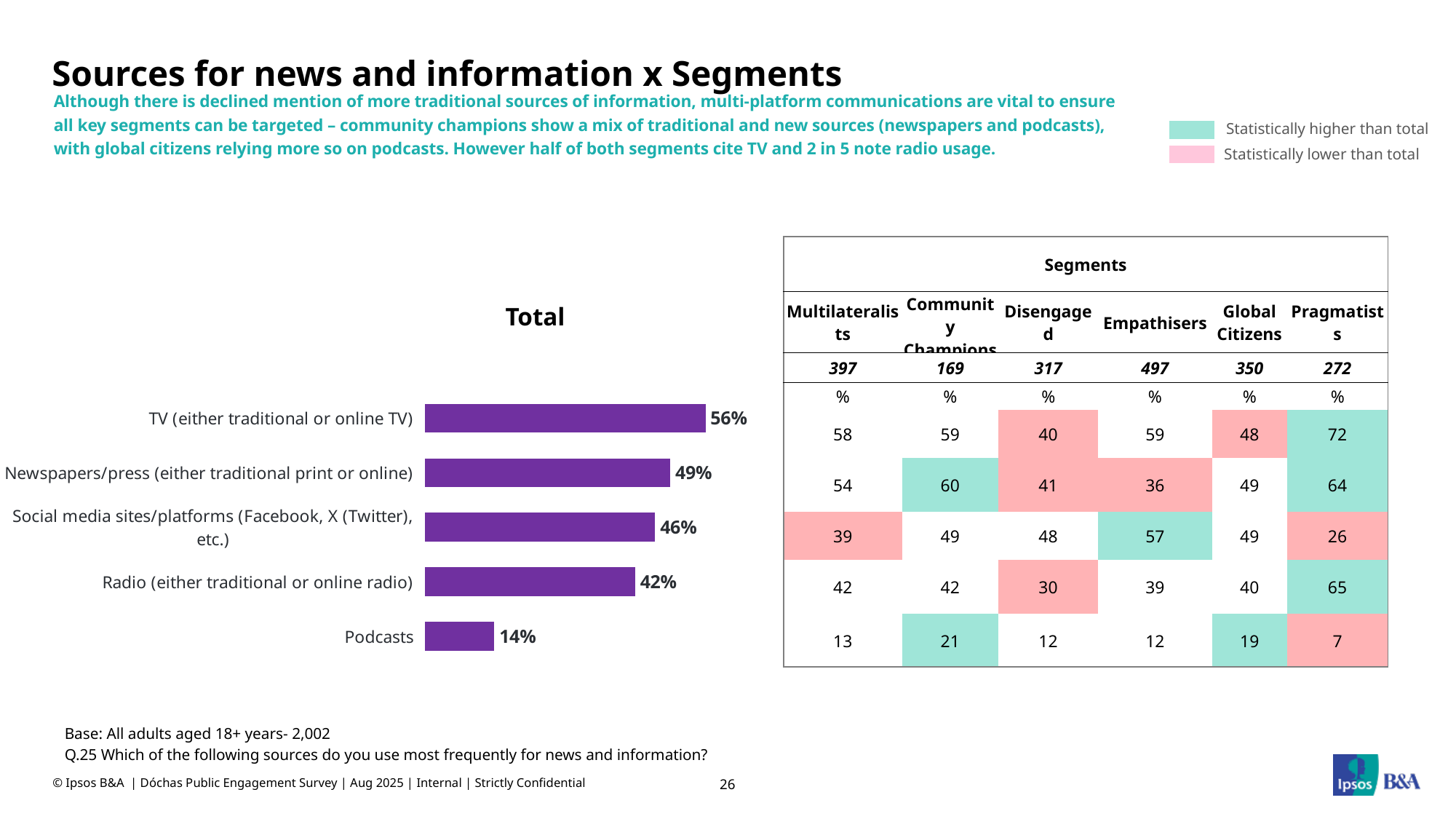
Which category has the lowest value in the Total chart? Podcasts What kind of chart is the Total chart? Bar chart What is the value for Podcasts in the Total chart? 14% What is the value for Radio (either traditional or online radio) in the Total chart? 42% What is the title of the chart on the slide? Total What colour are the bars in the Total chart? Purple What is the value for TV (either traditional or online TV) in the Total chart? 56% How many categories are shown in the Total chart? 5 Which is larger in the Total chart: Newspapers/press (either traditional print or online) or Social media sites/platforms (Facebook, X (Twitter), etc.)? Newspapers/press (either traditional print or online) Which category has the highest value in the Total chart? TV (either traditional or online TV) What is the difference between the values for TV (either traditional or online TV) and Podcasts in the Total chart? 42% What is the difference between the values for Newspapers/press (either traditional print or online) and Radio (either traditional or online radio) in the Total chart? 7%